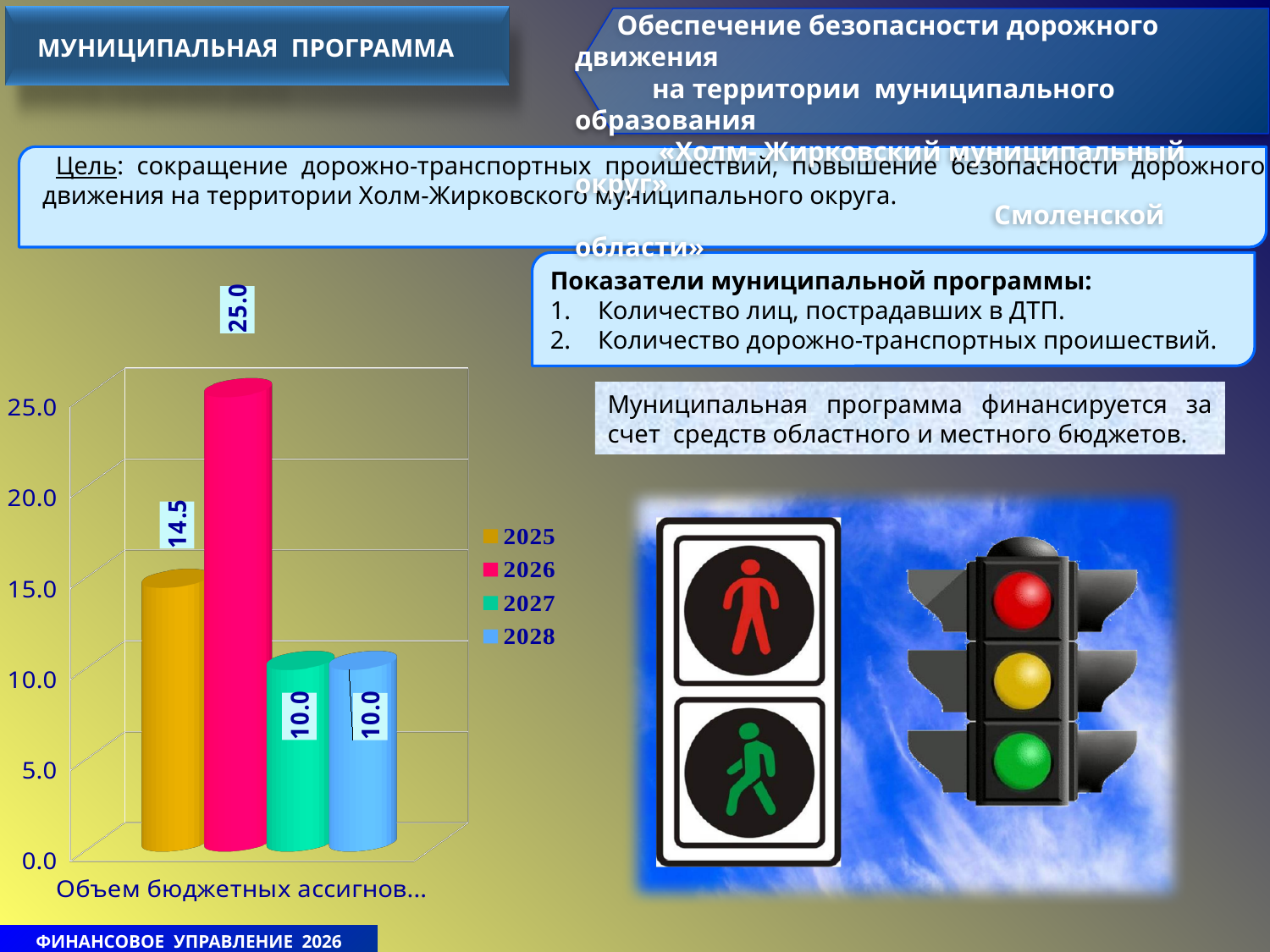
What is the difference between the values for 2025 and 2027? 4.5 Which is larger, the value for 2025 or the value for 2028? 2025 Is the value for 2025 greater or less than 15.0? less What colour is the bar for 2026 in the chart? pink What is the difference between the values for 2026 and 2025? 10.5 What is the value for 2027 in the chart? 10.0 What is the value for 2025 in the chart? 14.5 How many series does the legend list? 4 Which year has the highest value in the chart? 2026 What kind of chart is shown on the slide? bar chart What is the value for 2028 in the chart? 10.0 What is the value for 2026 in the chart? 25.0